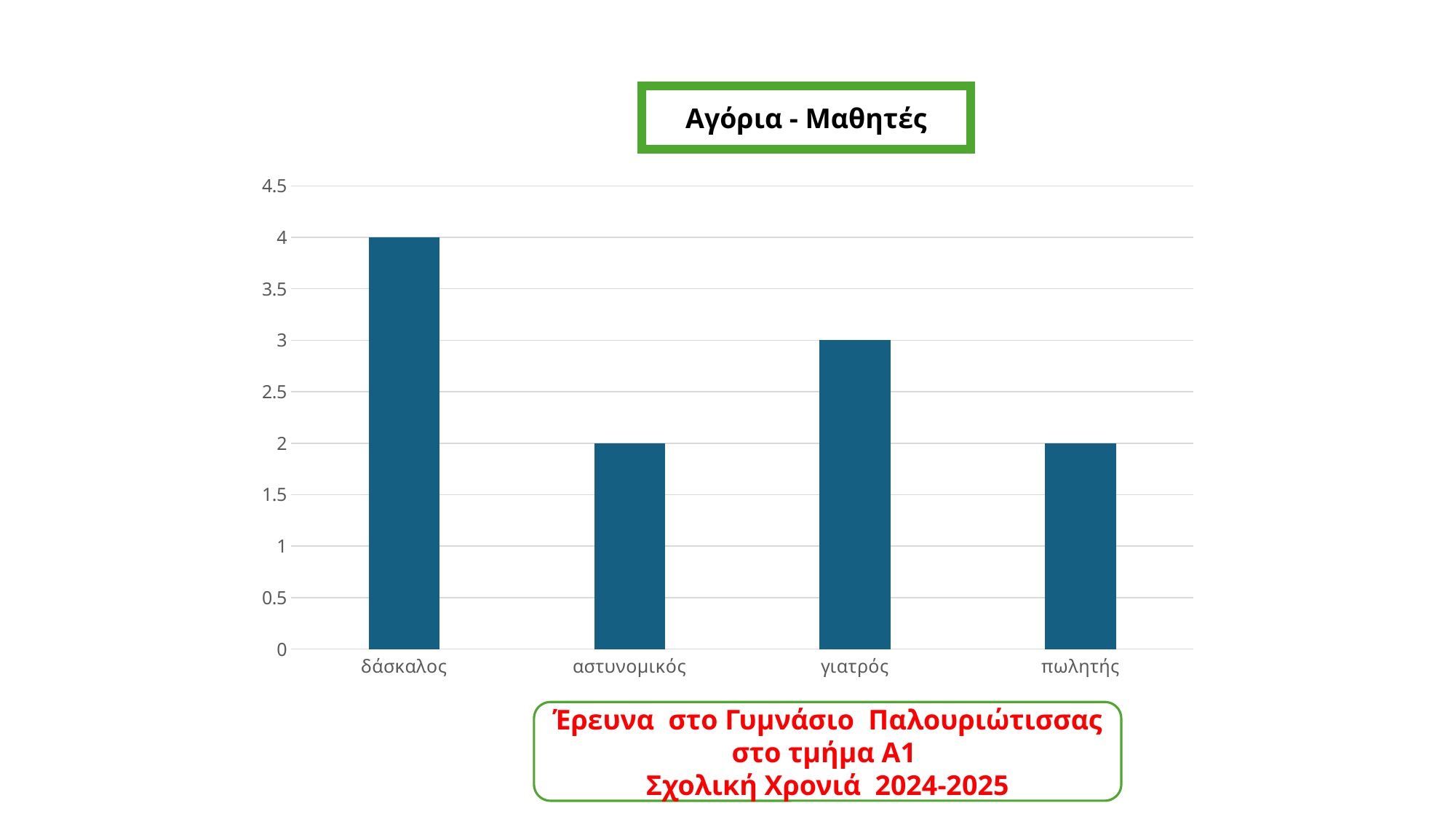
What is the title of the chart? Αγόρια - Μαθητές What is the difference between the values for δάσκαλος and πωλητής? 2 What is the value for γιατρός? 3 How many categories are shown on the x axis? 4 Which category has the highest value? δάσκαλος Is the value for γιατρός greater or less than 2.5? greater Which is larger, the value for γιατρός or the value for αστυνομικός? γιατρός What is the value for δάσκαλος? 4 What kind of chart is shown on the slide? bar chart What is the value for πωλητής? 2 What is the difference between the values for δάσκαλος and γιατρός? 1 What is the value for αστυνομικός? 2